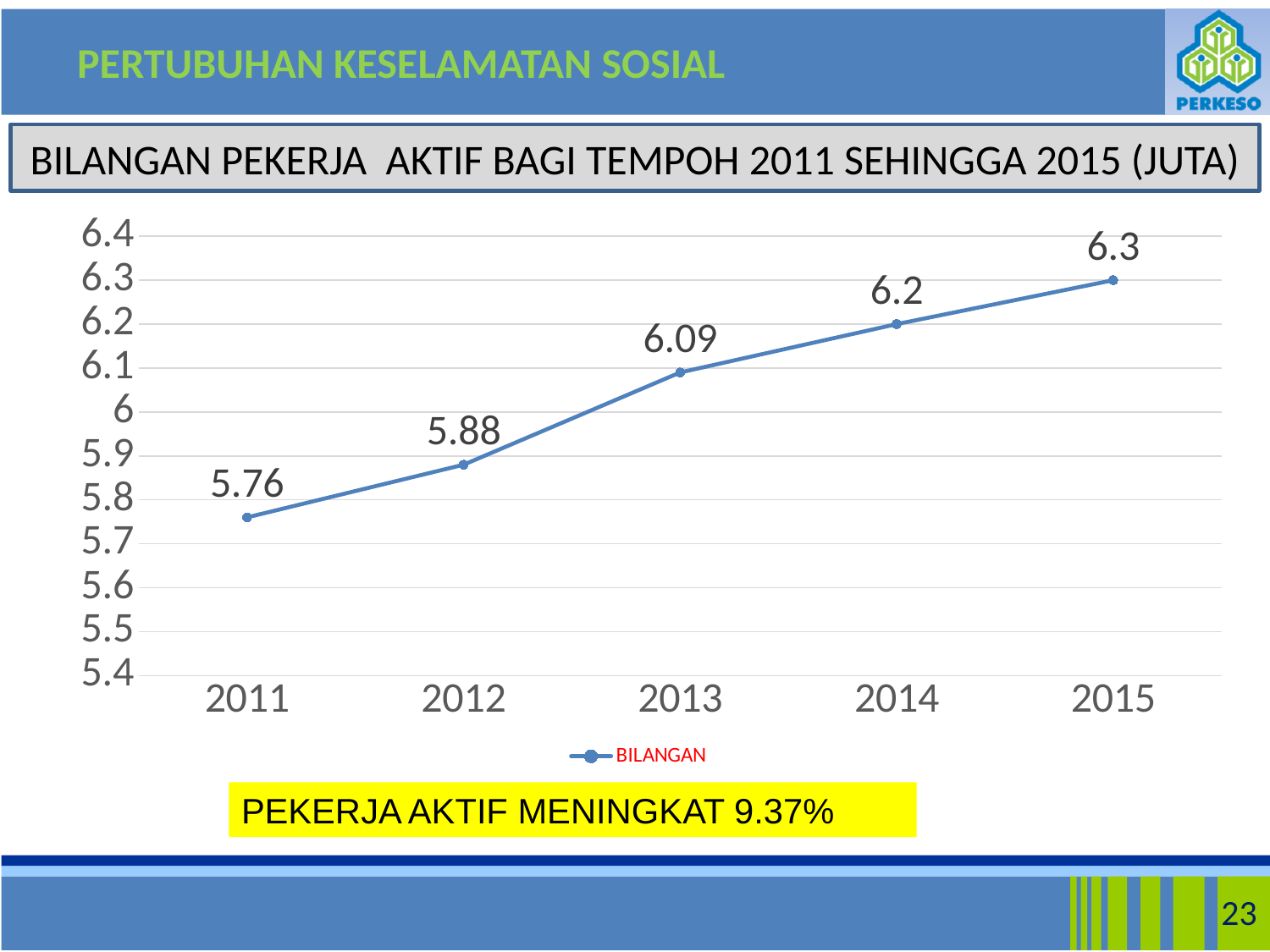
What is the difference between the values for 2015 and 2011? 0.54 Which is larger, the value for 2012 or the value for 2014? 2014 Is the value for 2012 greater or less than 6? less Do the values rise or fall from 2011 to 2015? rise What is the value for 2011? 5.76 How many years are plotted on the chart? 5 What kind of chart is shown? line chart What is the difference between the values for 2013 and 2012? 0.21 What is the value for 2015? 6.3 Which year has the highest value? 2015 Which year has the lowest value? 2011 What is the value for 2013? 6.09